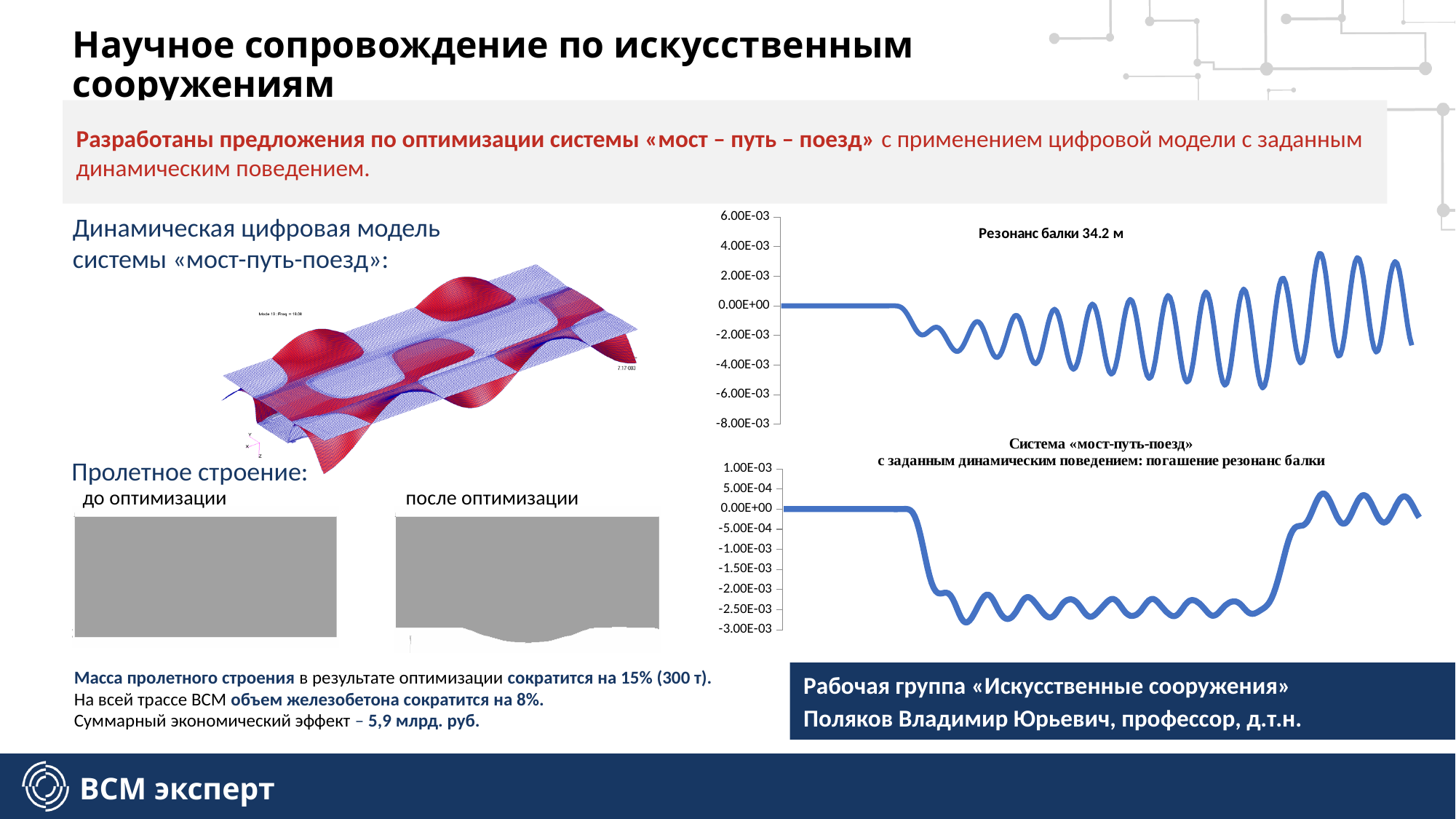
What is the title of the upper chart on the right side of the slide? Резонанс балки 34.2 м What kind of chart is the chart titled «Резонанс балки 34.2 м»? line chart In the lower chart «Система «мост-путь-поезд»... погашение резонанс балки», is the highest point of the line greater or less than 1.00E-03? less In the lower chart «Система «мост-путь-поезд»... погашение резонанс балки», what is the highest value shown on the vertical axis? 1.00E-03 In the chart «Резонанс балки 34.2 м», is the highest peak of the line greater or less than 2.00E-03? greater In the chart «Резонанс балки 34.2 м», does the amplitude of the oscillations increase or decrease from left to right along the x axis? increase In the lower chart «Система «мост-путь-поезд»... погашение резонанс балки», what is the lowest value shown on the vertical axis? -3.00E-03 In the chart «Резонанс балки 34.2 м», what is the highest value shown on the vertical axis? 6.00E-03 In the lower chart «Система «мост-путь-поезд»... погашение резонанс балки», is the lowest point of the line greater or less than -2.50E-03? less In the chart «Резонанс балки 34.2 м», what is the lowest value shown on the vertical axis? -8.00E-03 What kind of chart is the lower chart on the right, titled «Система «мост-путь-поезд» с заданным динамическим поведением: погашение резонанс балки»? line chart